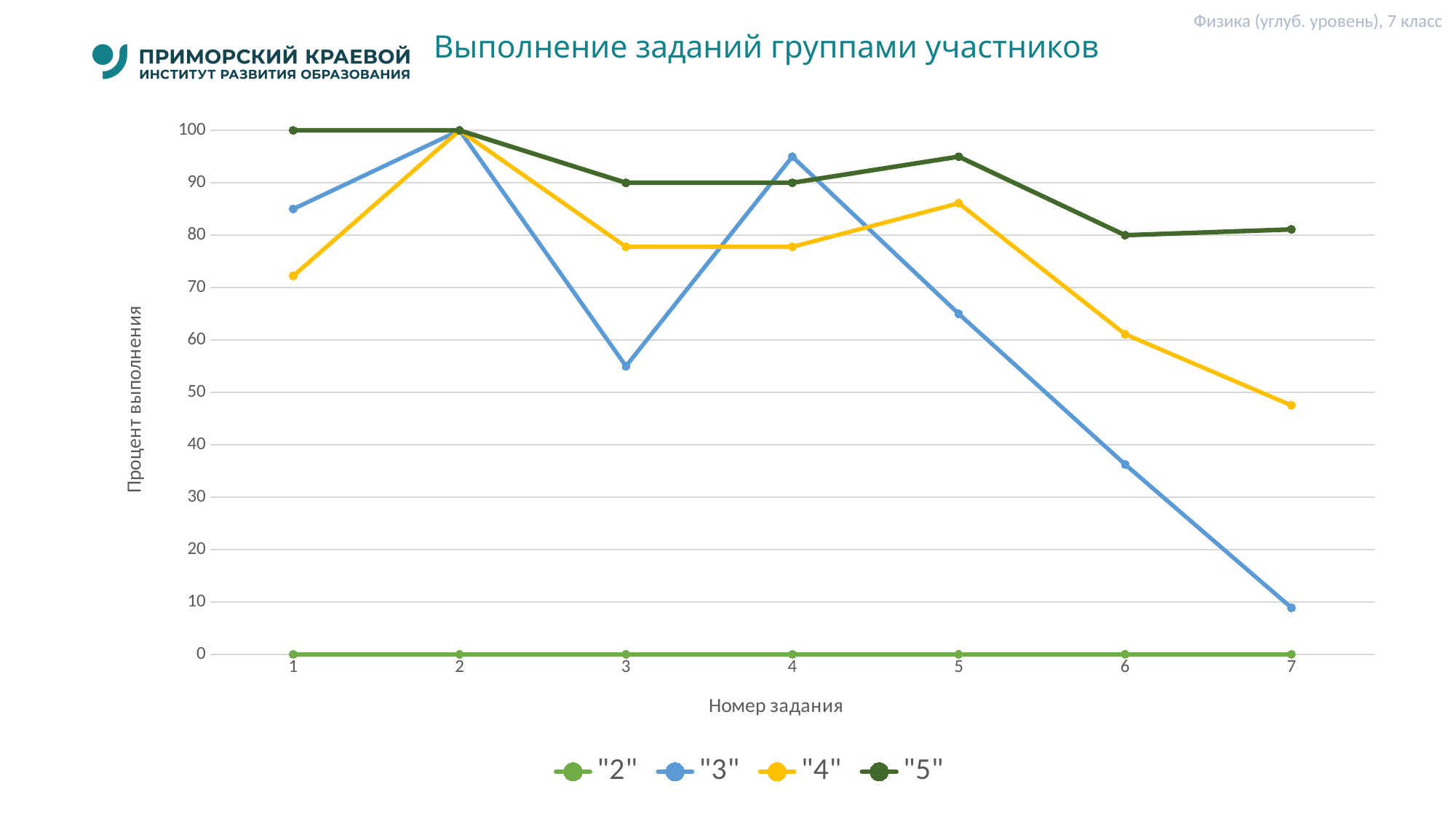
Which is larger at task 5: the value for series "4" or series "3"? "4" What is the value for series "2" at task 4? 0 What is the value for series "5" at task 3? 90 How many series does the legend list? 4 Which series has the lowest value at task 7? "2" What is the value for series "5" at task 1? 100 Is the value for series "3" at task 7 greater or less than 10? less What kind of chart is shown on the slide? line chart Does the value for series "3" rise or fall from task 4 to task 7? fall How many task numbers are shown on the x axis? 7 What is the value for series "3" at task 2? 100 Is the value for series "4" at task 6 greater or less than 60? greater